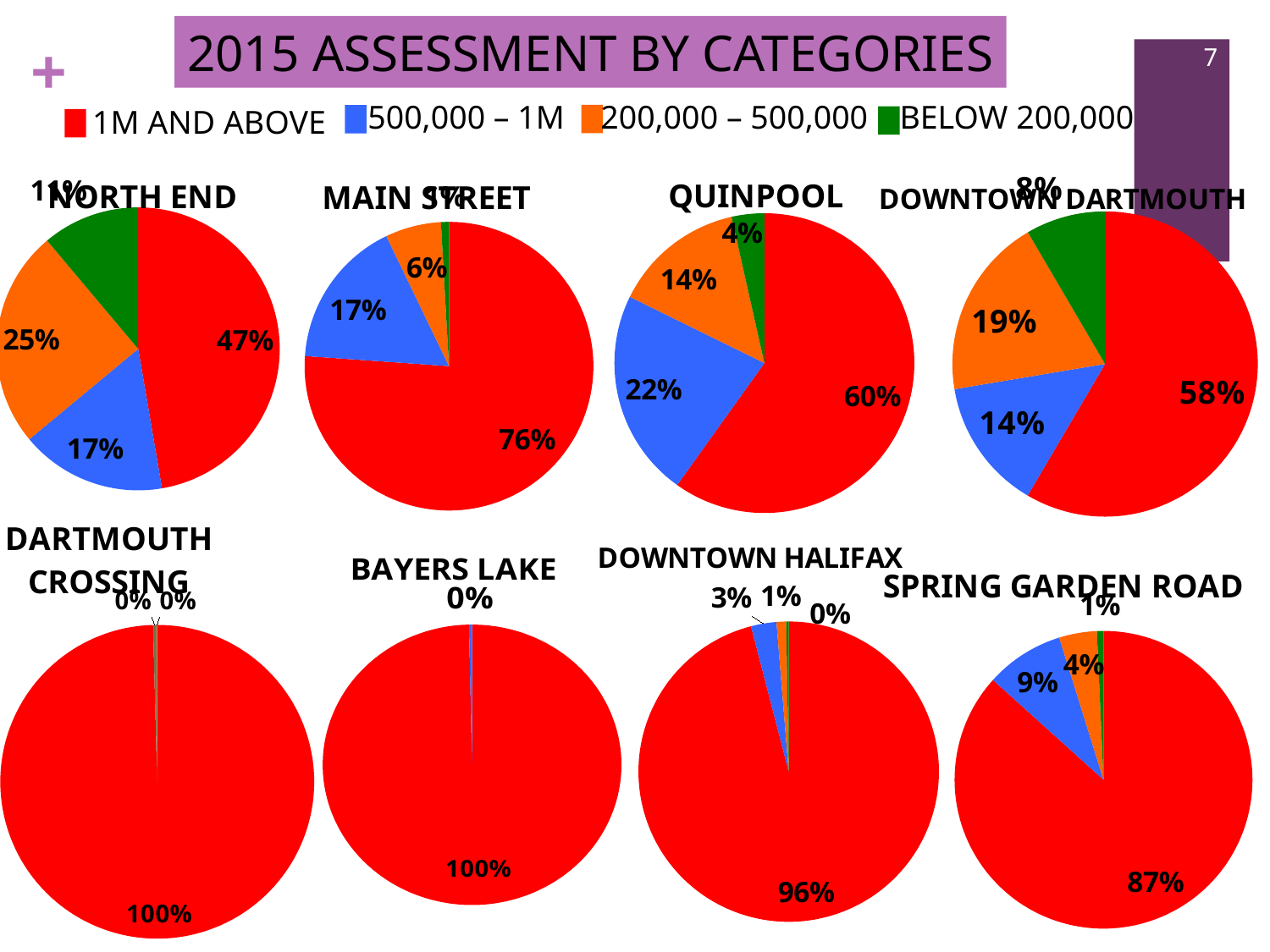
In the QUINPOOL pie chart, what share is BELOW 200,000? 4% How many pie charts are on the slide? 8 Which is larger: the 1M AND ABOVE share in QUINPOOL or in MAIN STREET? MAIN STREET In the MAIN STREET pie chart, what share is 500,000 – 1M? 17% In the NORTH END pie chart, what share is 200,000 – 500,000? 25% In the DOWNTOWN DARTMOUTH pie chart, which category has the largest share? 1M AND ABOVE In the SPRING GARDEN ROAD pie chart, what is the difference between the 1M AND ABOVE share and the 500,000 – 1M share? 78% How many categories does the legend list? 4 What kind of charts are shown on the slide? Pie charts